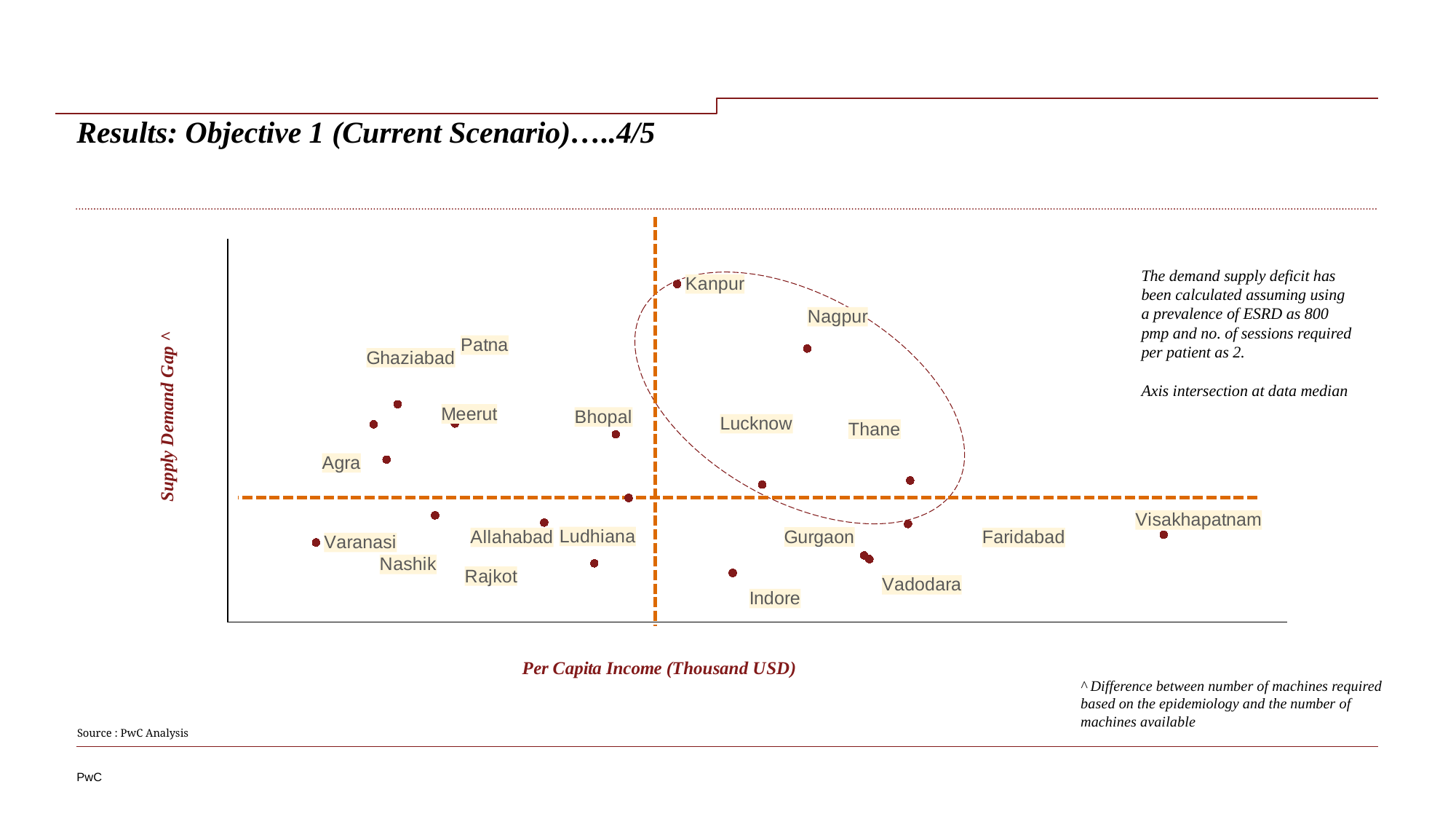
Which city has the highest Supply Demand Gap on the chart? Kanpur Which city has a higher Per Capita Income, Visakhapatnam or Faridabad? Visakhapatnam Which city has the highest Per Capita Income on the chart? Visakhapatnam Which city has a higher Per Capita Income, Thane or Bhopal? Thane Which city has a higher Supply Demand Gap, Patna or Agra? Patna What kind of chart is shown on the slide? Scatter chart What is the title of the horizontal axis of the chart? Per Capita Income (Thousand USD) Which cities are enclosed by the dashed ellipse on the chart? Kanpur, Nagpur, Lucknow, Thane How many cities are labelled on the chart? 19 Which city has the lowest Supply Demand Gap on the chart? Indore Which city has the lowest Per Capita Income on the chart? Varanasi